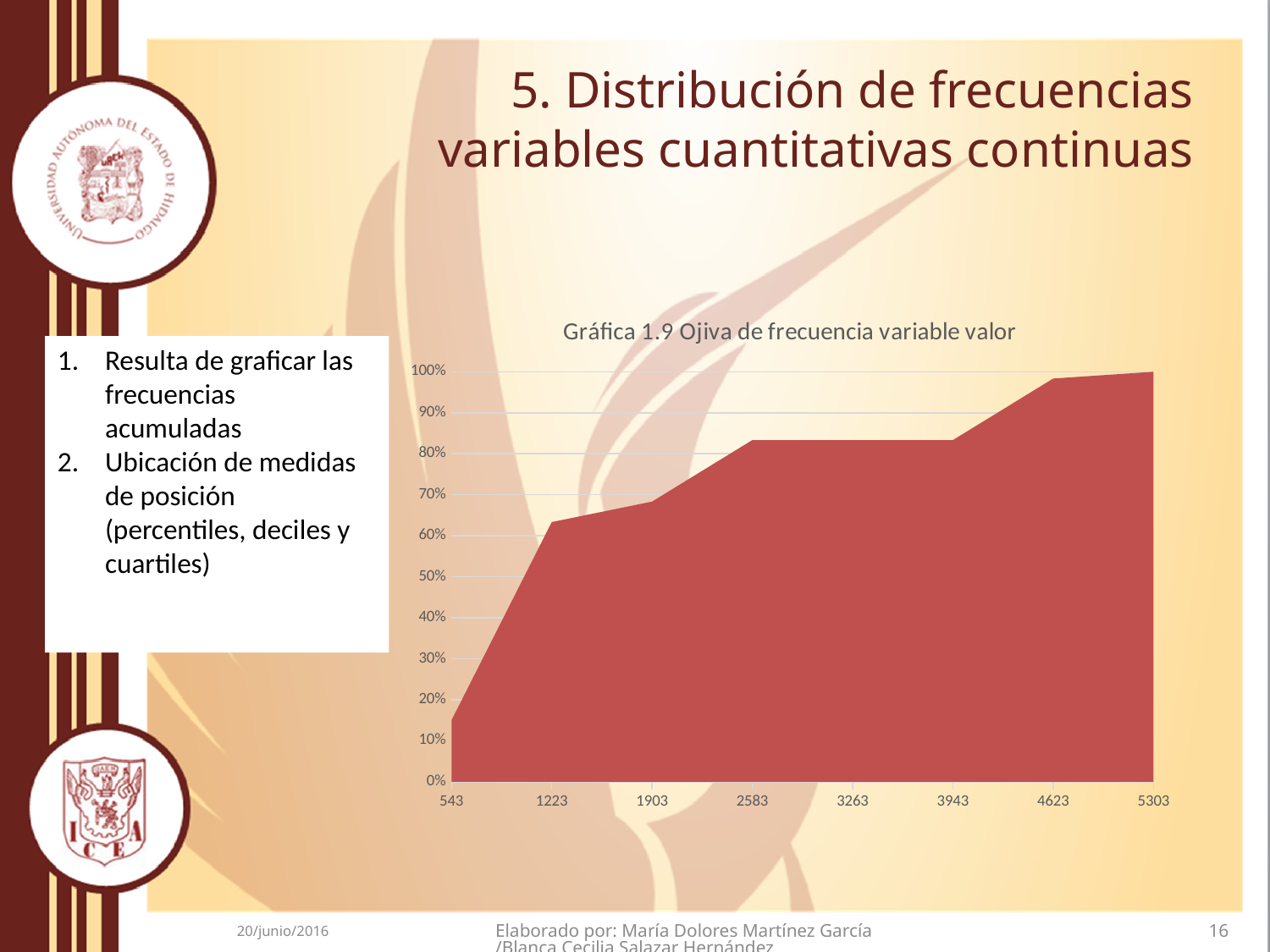
What kind of chart is shown on the slide? Area chart Which has the larger value, 543 or 1223? 1223 Which x-axis category has the highest value? 5303 What is the value at 5303? 100% Do the values rise or fall as you move along the x axis from 543 to 5303? Rise Is the value for 2583 greater or less than 80%? greater Is the value for 543 greater or less than 20%? less How many x-axis categories are plotted in the chart? 8 Which x-axis category has the lowest value? 543 What is the title of the chart? Gráfica 1.9 Ojiva de frecuencia variable valor Is the value for 1223 greater or less than 60%? greater